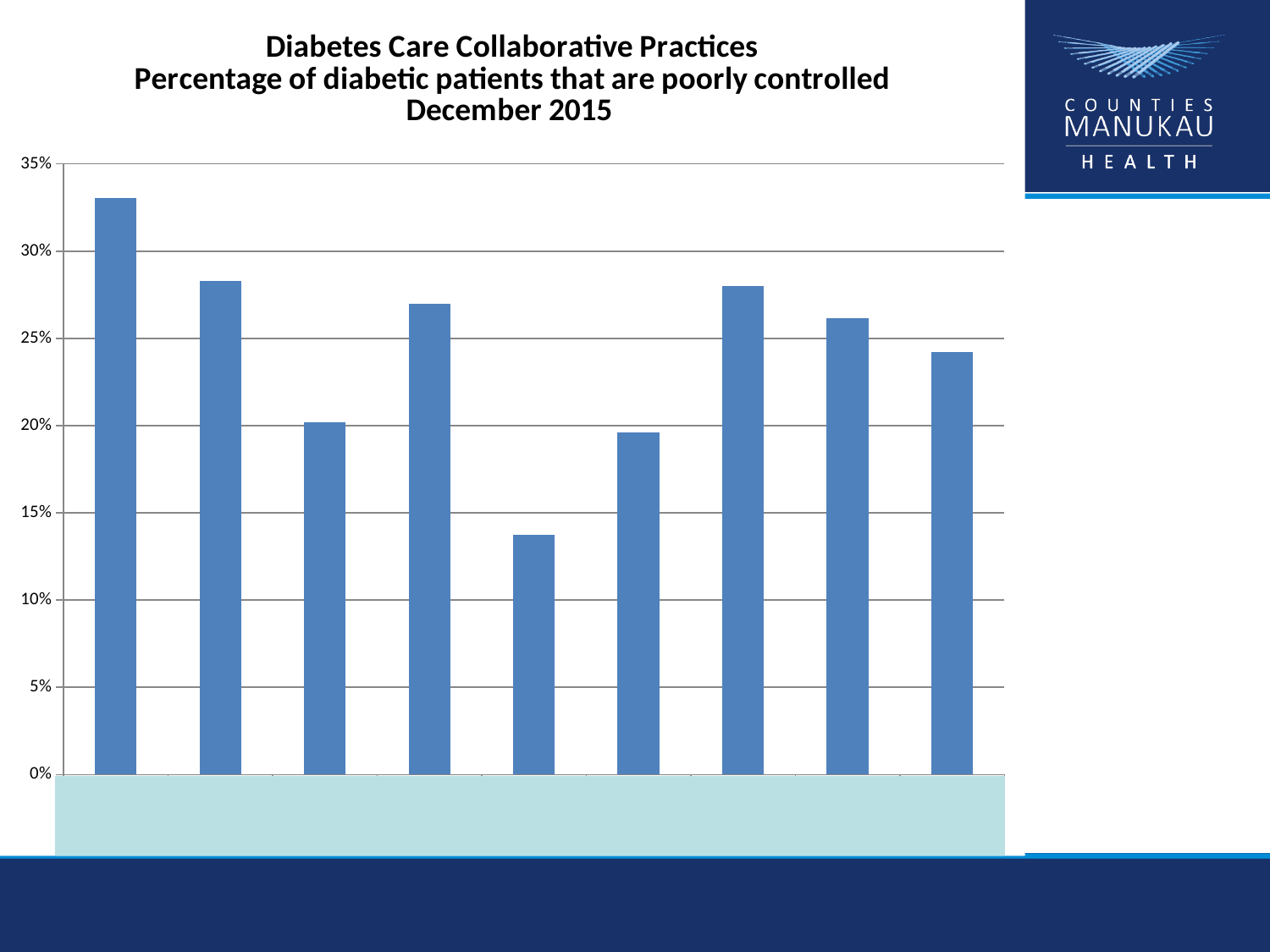
How many bars are plotted in the chart? 9 Is the value of the ninth (rightmost) bar greater or less than 25%? less Which bar, counting from the left, is the lowest in the chart? The fifth bar Which is larger, the first bar from the left or the second bar from the left? The first bar Which bar, counting from the left, is the highest in the chart? The first bar Is the value of the first (leftmost) bar greater or less than 30%? greater What kind of chart is shown on the slide? Bar chart What is the highest value shown on the vertical axis of the chart? 35% Is the value of the fifth bar from the left greater or less than 15%? less What month and year does the chart title say the data is for? December 2015 Which is larger, the third bar from the left or the fifth bar from the left? The third bar